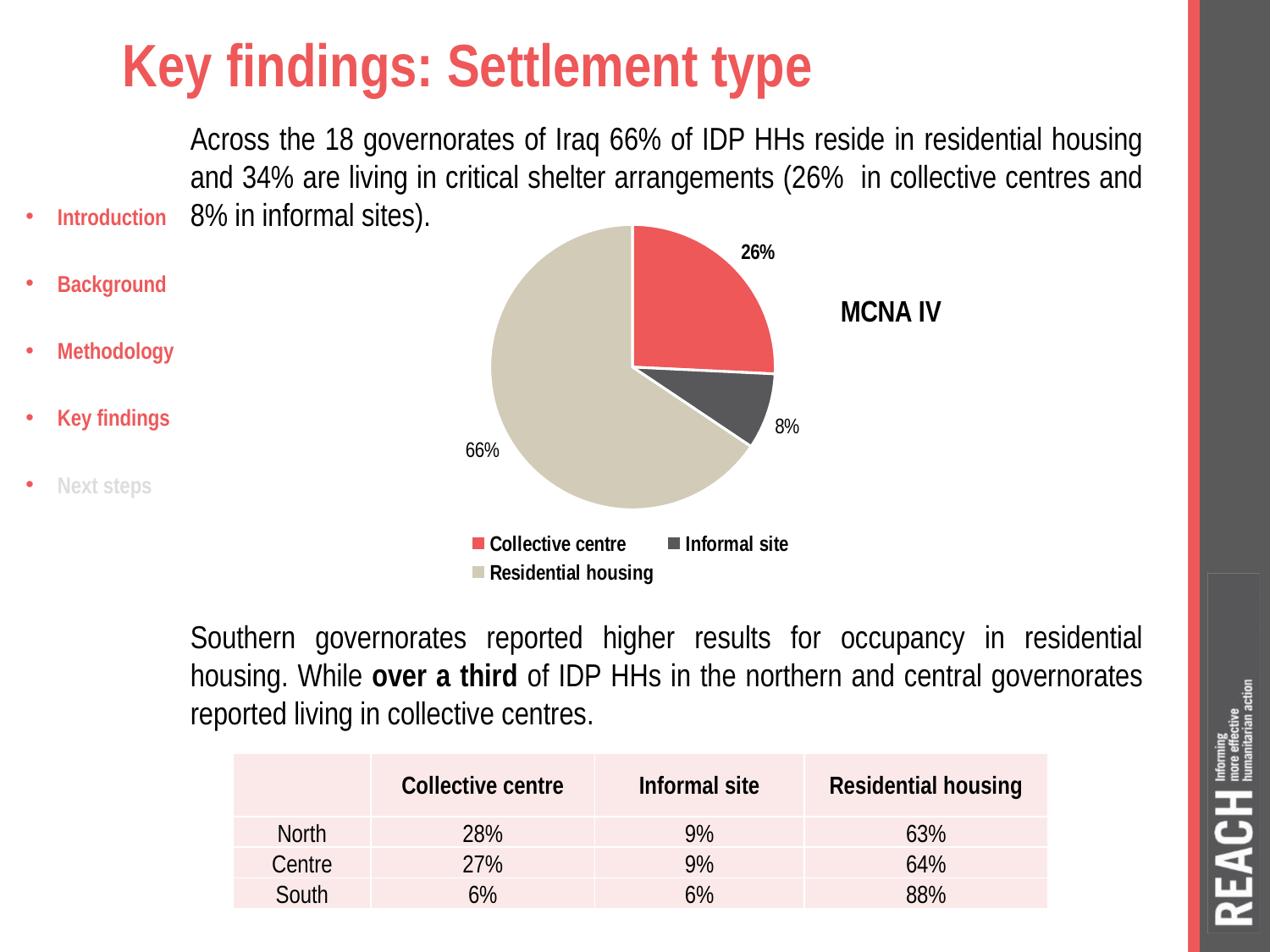
What label appears next to the pie chart as its title? MCNA IV What share of the pie does Informal site represent? 8% What share of the pie does Residential housing represent? 66% What is the difference in percentage points between Residential housing and Collective centre? 40 What kind of chart is shown on the slide? pie chart Which category has the smallest slice of the pie? Informal site What share of the pie does Collective centre represent? 26% Which category has the largest slice of the pie? Residential housing Which is larger, the Collective centre slice or the Informal site slice? Collective centre What is the difference in percentage points between Collective centre and Informal site? 18 How many entries does the legend of the pie chart list? 3 How many slices does the pie chart have? 3